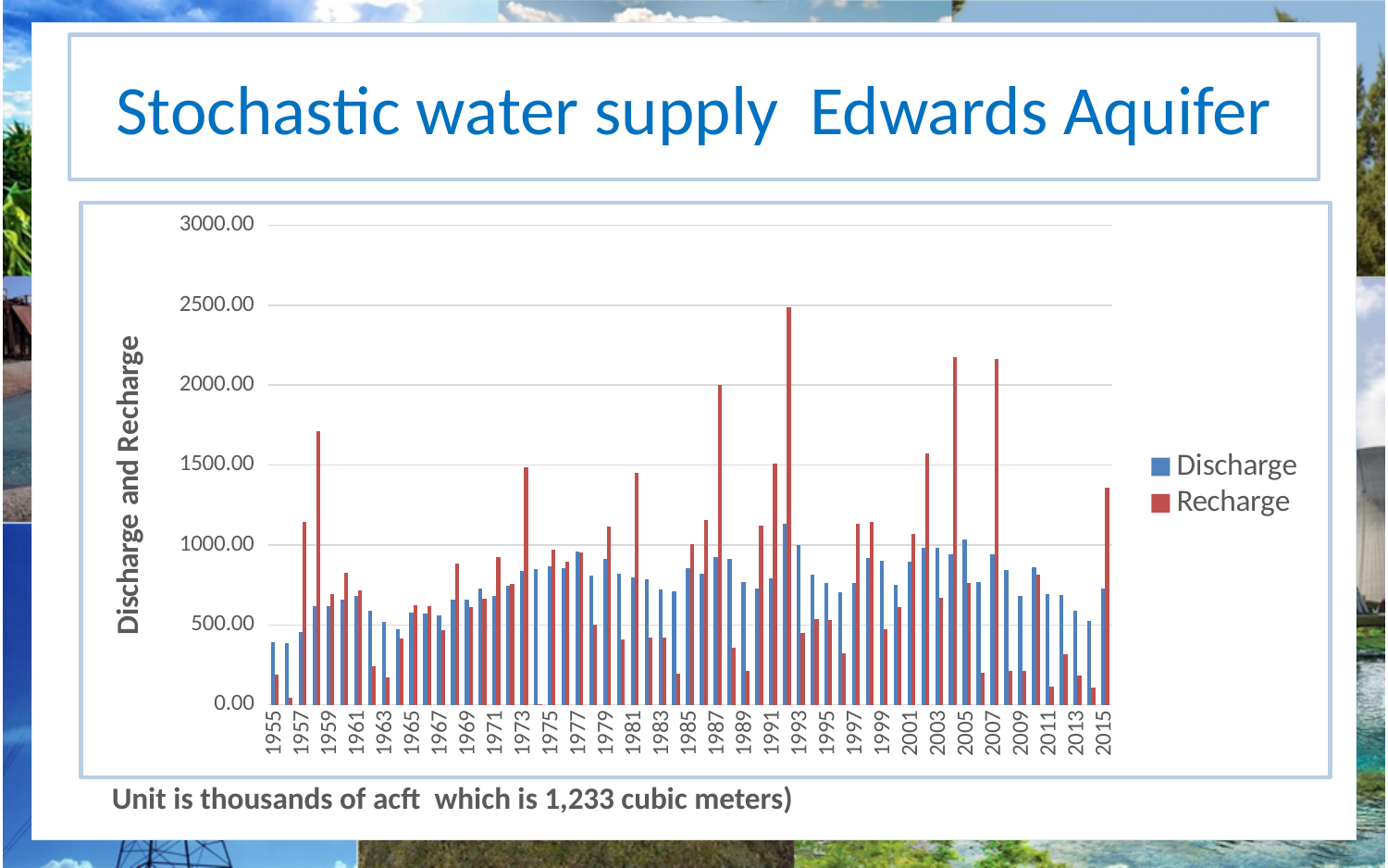
Is the Recharge value for 2015 greater or less than 1000? greater In 1992, which is larger, Discharge or Recharge? Recharge Is the Recharge value for 1992 greater or less than 2000? greater Is the Discharge value for 1955 greater or less than 500? less What is the title of the vertical axis? Discharge and Recharge In 1955, which is larger, Discharge or Recharge? Discharge What are the two series named in the legend? Discharge and Recharge What kind of chart is shown on the slide? Bar chart In which year is the Recharge value highest? 1992 How many series does the legend list? 2